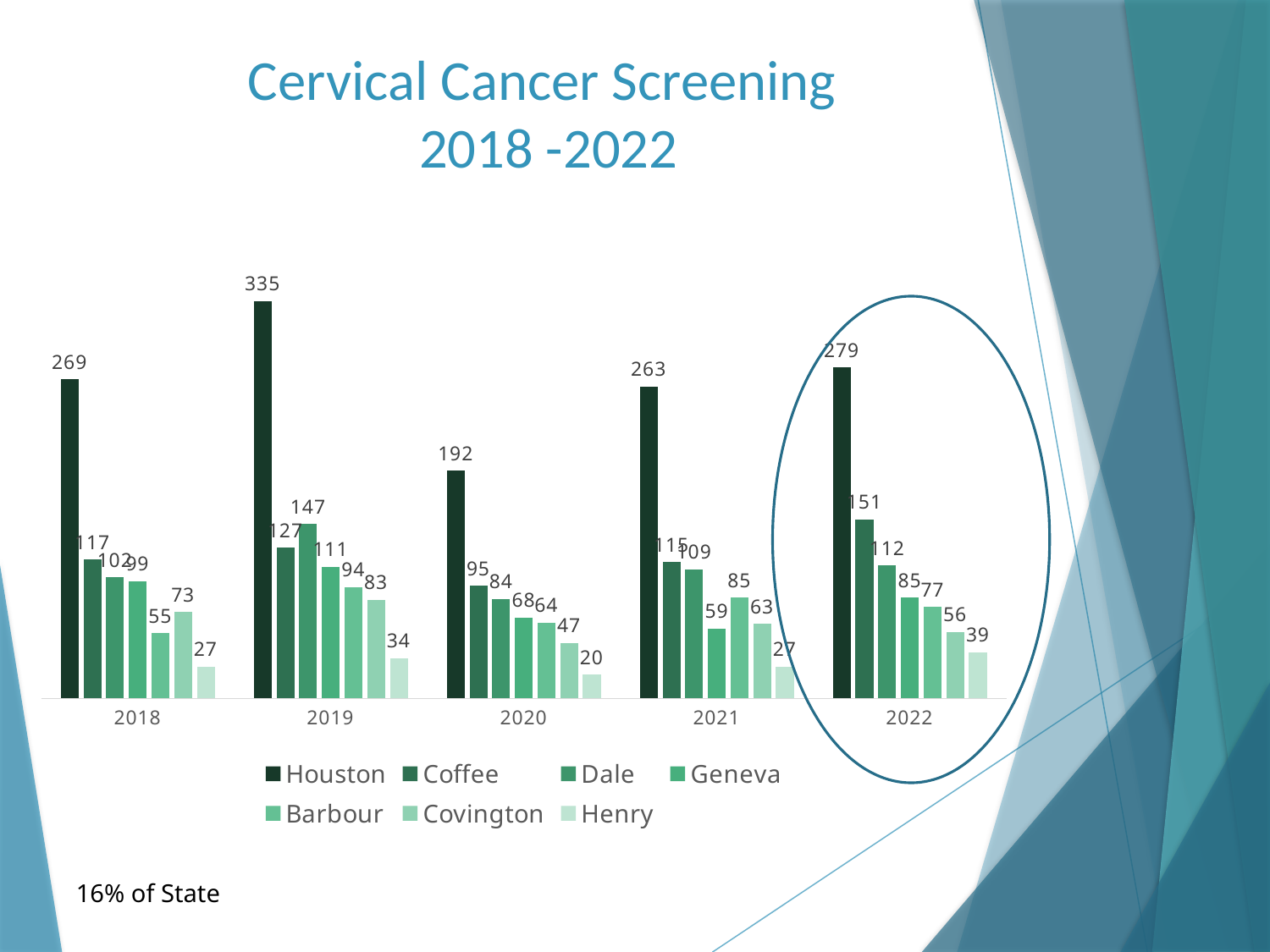
In 2022, which is larger, the Coffee value or the Dale value? Coffee In which year is the Houston value lowest? 2020 What kind of chart is shown on the slide? Bar chart What is the value for Coffee in 2022? 151 What is the title of the chart? Cervical Cancer Screening 2018 -2022 Does the Houston value rise or fall from 2019 to 2020? Fall In which year is the Houston value highest? 2019 What is the value for Henry in 2020? 20 How many years are shown on the x axis? 5 What is the difference between the Houston values for 2022 and 2021? 16 How many series does the legend list? 7 What is the value for Houston in 2019? 335